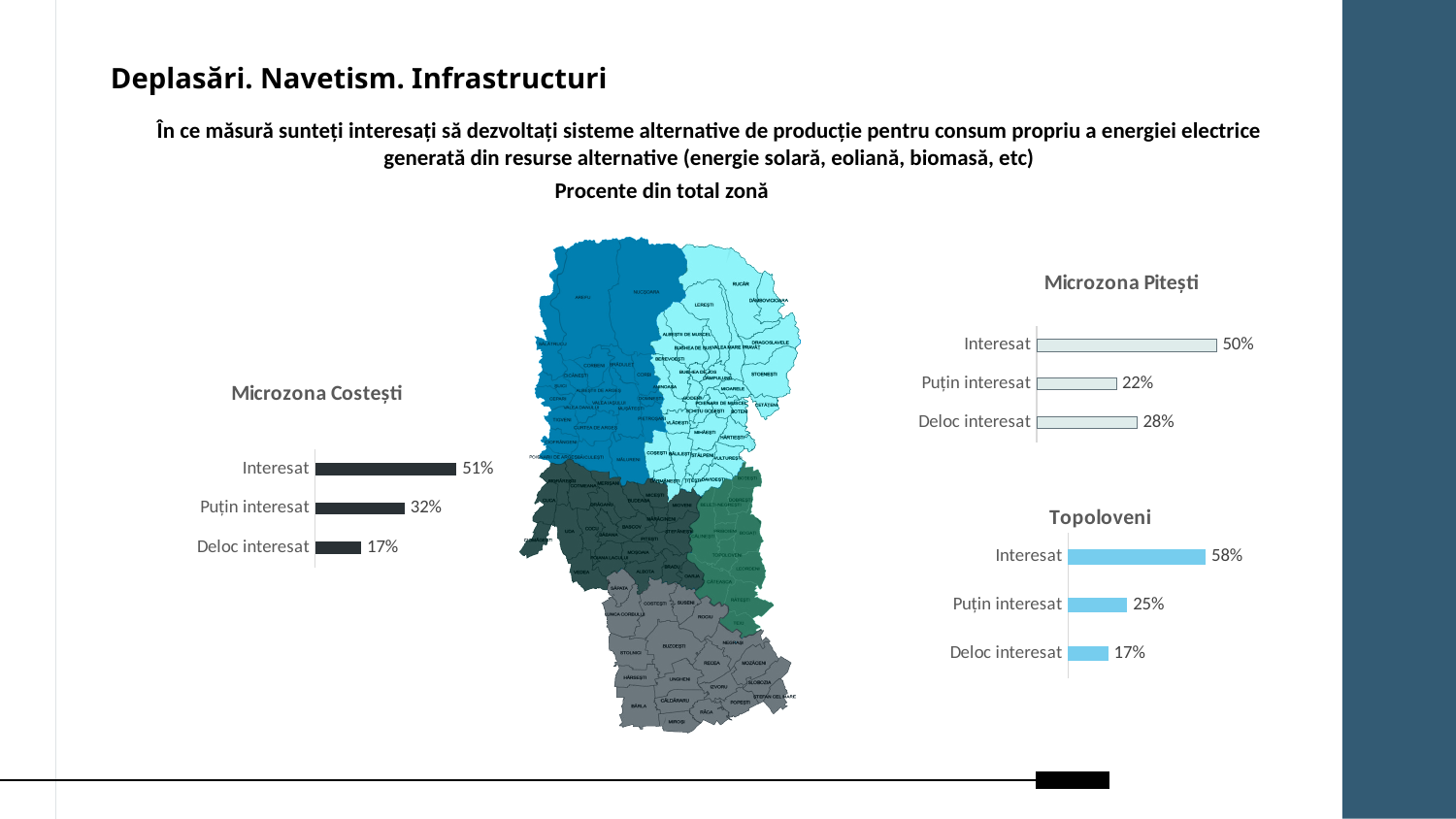
In the Microzona Pitești chart, which category has the highest value? Interesat In the Topoloveni chart, what is the value for Interesat? 58% In the Microzona Pitești chart, what is the difference between Deloc interesat and Puțin interesat? 6% How many categories does the Microzona Costești chart show? 3 In the Microzona Costești chart, what is the value for Interesat? 51% What type of chart is the Topoloveni chart? Bar chart In the Microzona Pitești chart, what is the value for Puțin interesat? 22% In the Microzona Costești chart, what is the difference between Interesat and Puțin interesat? 19% In the Topoloveni chart, which category has the lowest value? Deloc interesat In the Microzona Costești chart, what is the value for Deloc interesat? 17% In the Topoloveni chart, which is larger: Puțin interesat or Deloc interesat? Puțin interesat How many bar charts are on the slide? 3